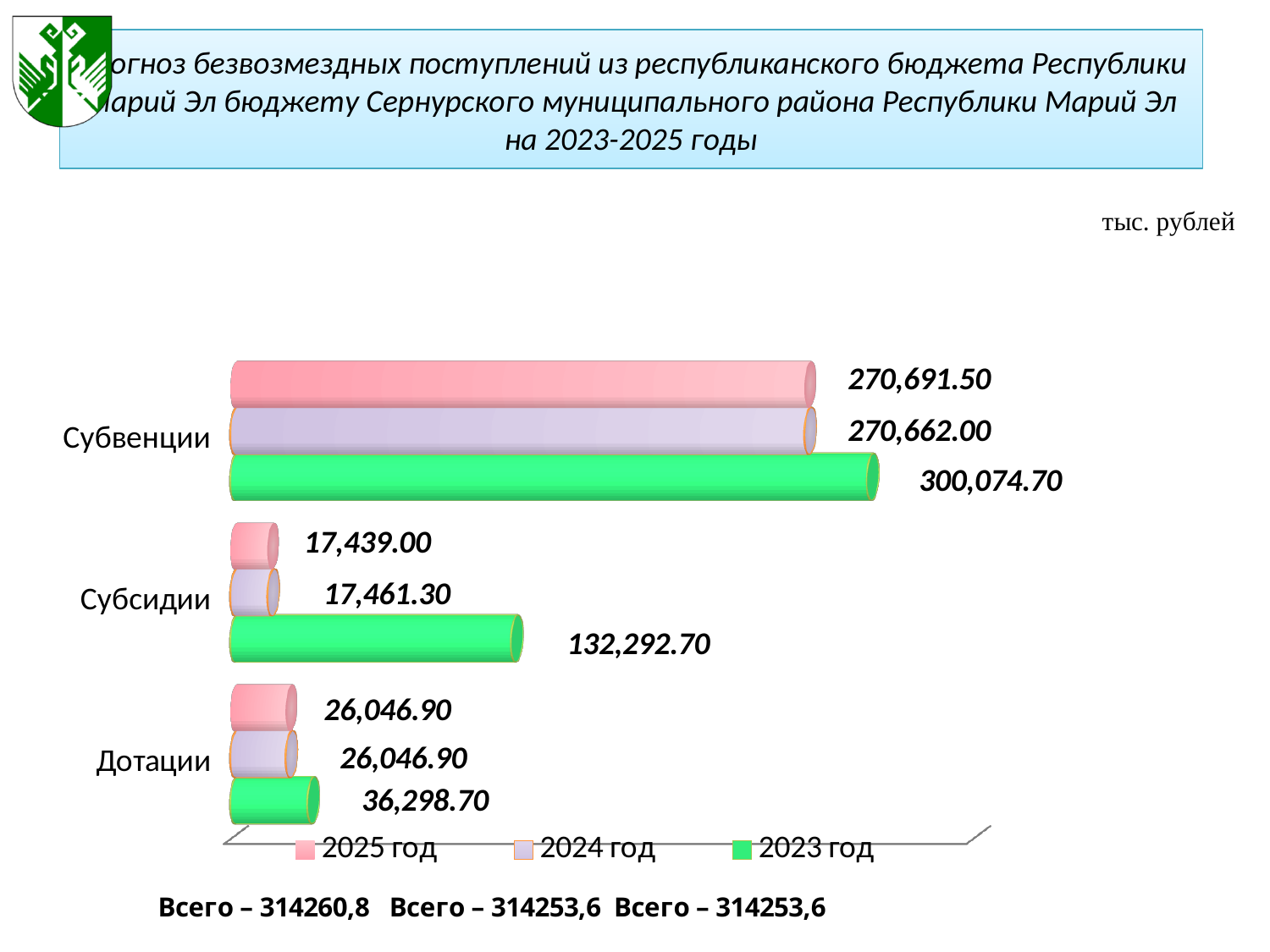
Which category has the highest value in the 2023 год series? Субвенции What is the value for Субсидии in the 2025 год series? 17,439.00 What is the difference between the 2023 год and 2025 год values for Субсидии? 114,853.70 What is the value for Субвенции in the 2024 год series? 270,662.00 How many series does the legend list? 3 What kind of chart is shown on the slide? Bar chart Which category has the lowest value in the 2025 год series? Субсидии What is the value for Дотации in the 2023 год series? 36,298.70 For Дотации, which is larger: the 2023 год value or the 2025 год value? 2023 год What is the difference between the 2023 год and 2024 год values for Субвенции? 29,412.70 How many categories are shown on the chart? 3 What is the value for Субвенции in the 2023 год series? 300,074.70